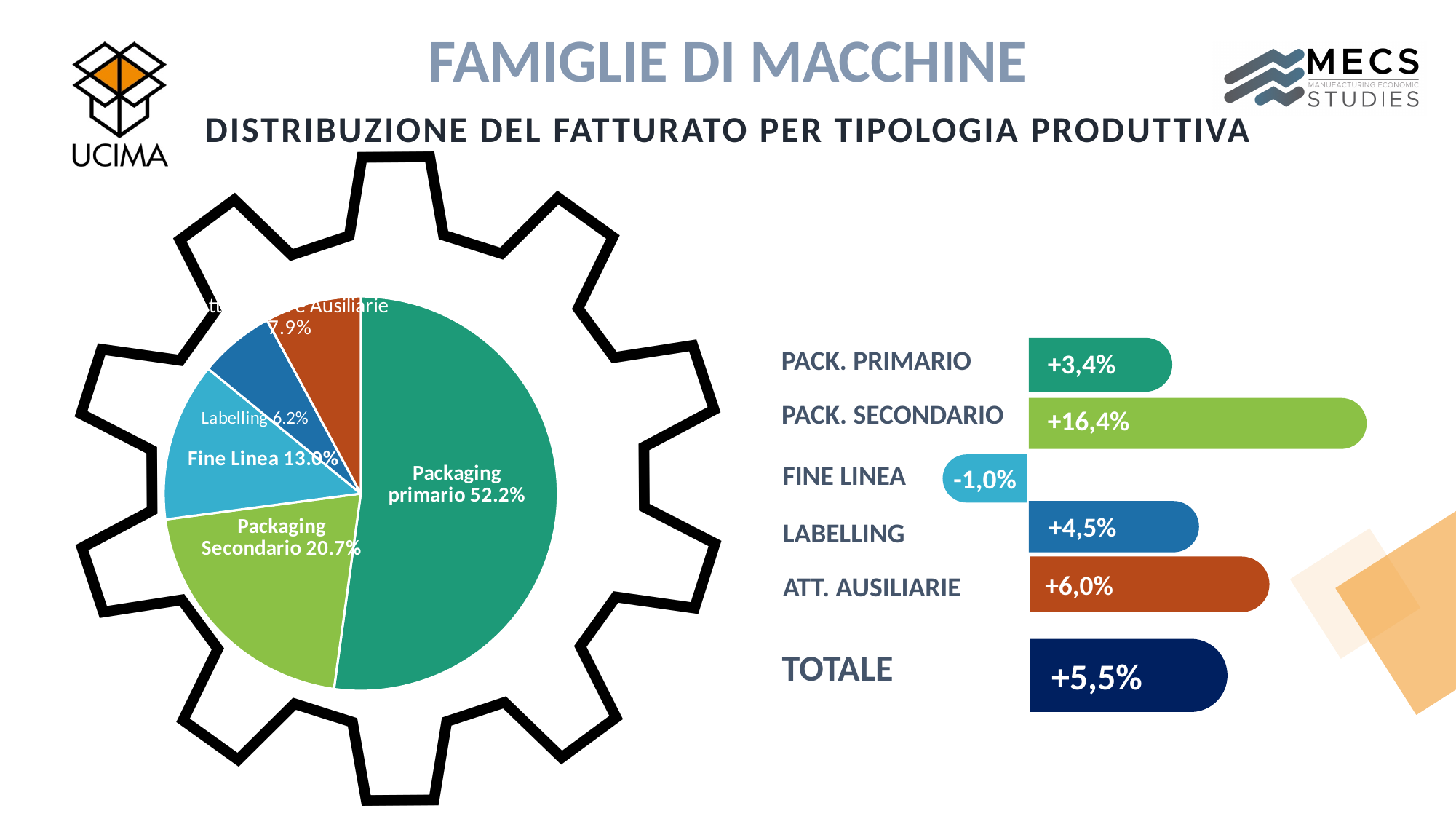
In the pie chart on the left, which category has the smallest slice? Labelling In the bar chart on the right, which category has the highest value? PACK. SECONDARIO In the pie chart on the left, what is the value for Packaging Secondario? 20.7% In the pie chart on the left, which category has the largest slice? Packaging primario In the pie chart on the left, how many slices are there? 5 In the bar chart on the right, which is larger, LABELLING or ATT. AUSILIARIE? ATT. AUSILIARIE In the pie chart on the left, what is the value for Fine Linea? 13.0% In the bar chart on the right, what is the value for PACK. SECONDARIO? +16,4% In the pie chart on the left, what is the difference between the Packaging primario and Packaging Secondario shares? 31.5% What kind of chart is shown on the left of the slide? Pie chart In the pie chart on the left, what share does Packaging primario have? 52.2% In the bar chart on the right, what is the value for FINE LINEA? -1,0%